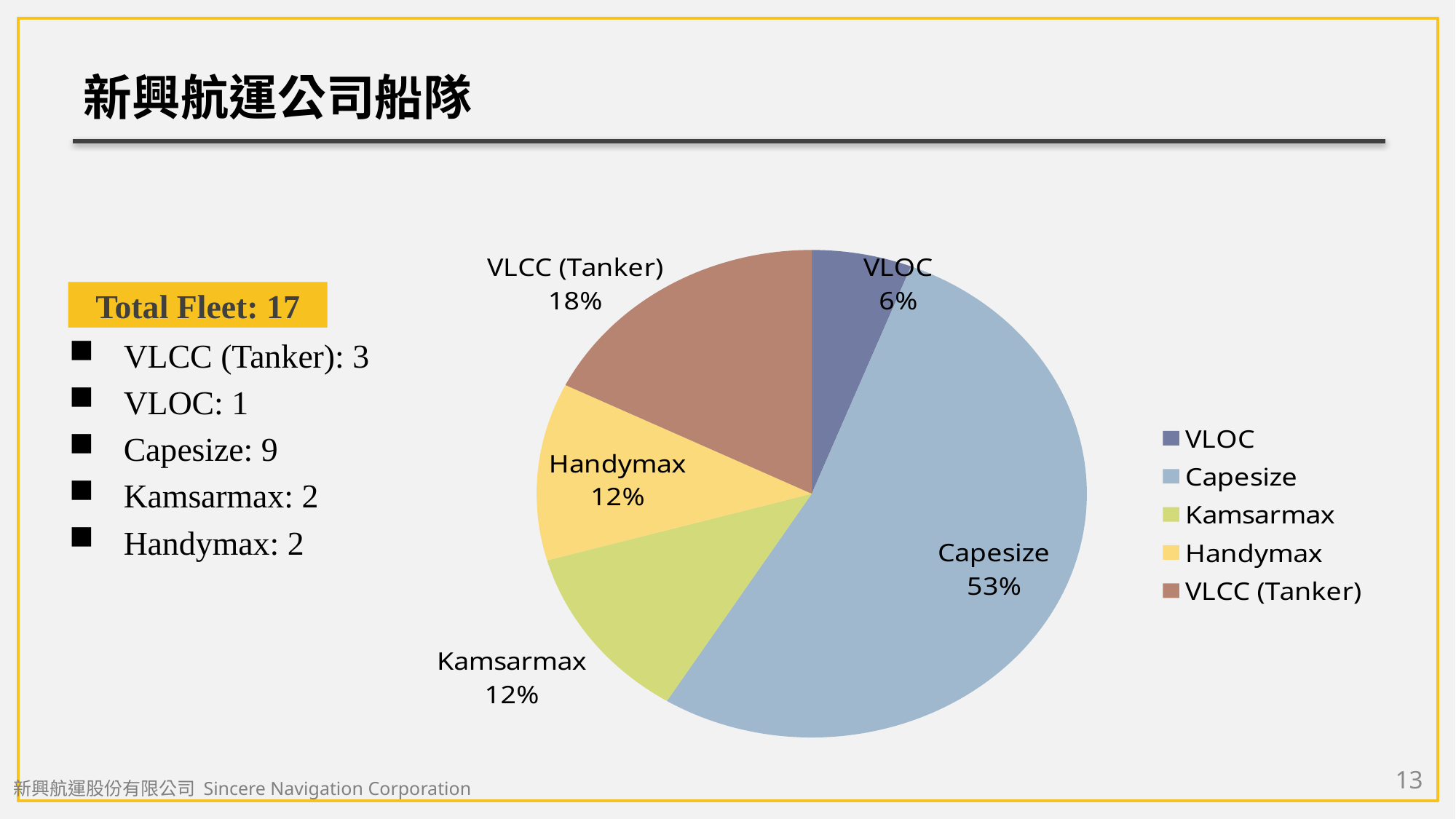
Which category has the smallest slice of the pie? VLOC Which is larger, the VLCC (Tanker) slice or the Kamsarmax slice? VLCC (Tanker) What percentage is shown for VLOC? 6% What share of the pie does Capesize represent? 53% What type of chart is shown on the slide? pie chart Which category has the largest slice of the pie? Capesize What is the difference in percentage points between Capesize and VLCC (Tanker)? 35 How many categories are shown in the pie chart? 5 How many entries does the legend list? 5 What colour is the Capesize slice in the pie chart? light blue What percentage is shown for Handymax? 12% What percentage is shown for VLCC (Tanker)? 18%